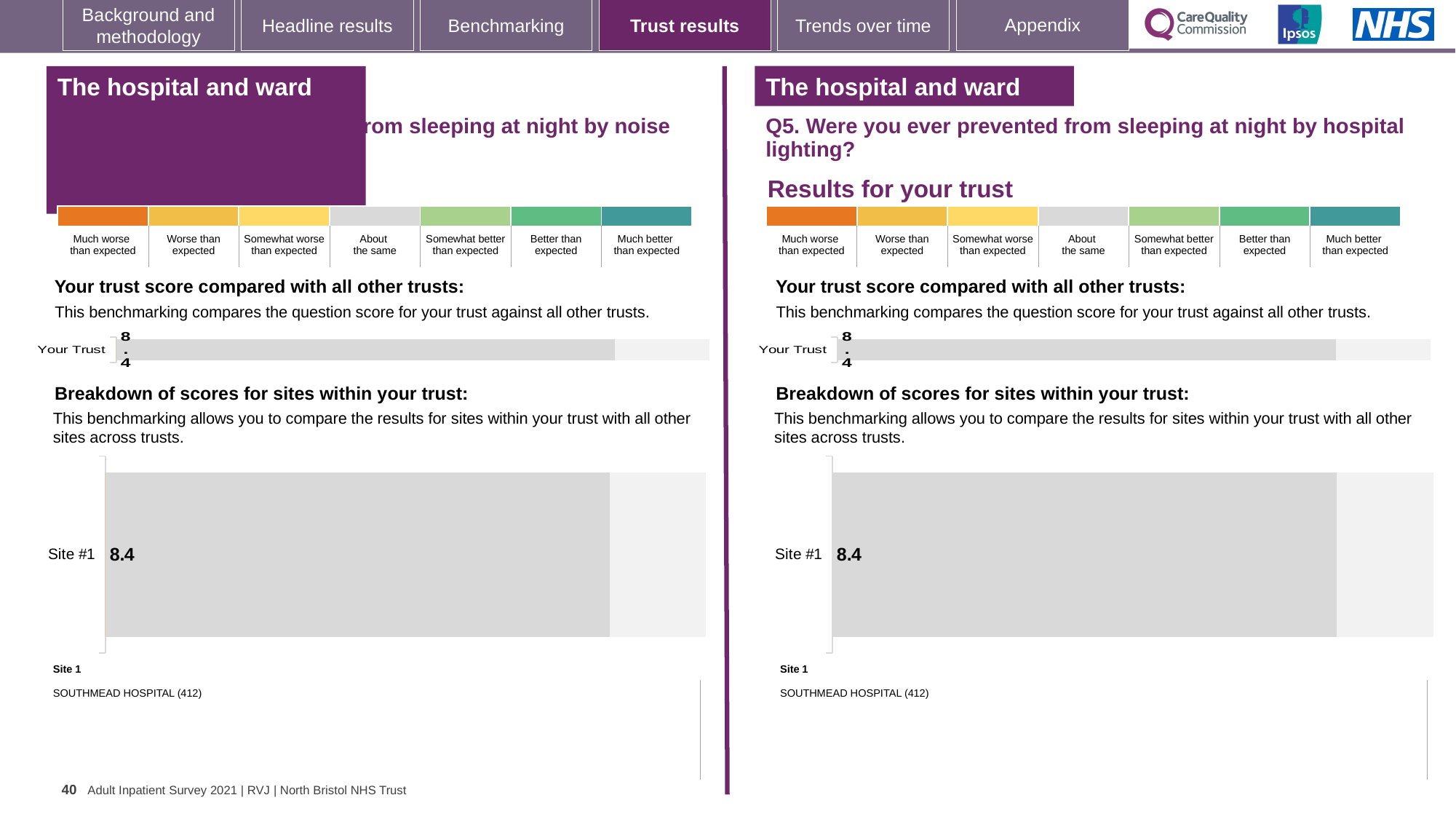
On the right half of the slide (Q5, hospital lighting), which hospital is listed as Site 1 below the site breakdown chart? SOUTHMEAD HOSPITAL (412) On the right half of the slide (Q5, hospital lighting), how many sites are shown in the 'Breakdown of scores for sites within your trust' chart? 1 Is the Site #1 score on the left half of the slide (sleeping at night by noise) larger than, smaller than, or equal to the Site #1 score on the right half (Q5, hospital lighting)? Equal On the right half of the slide (Q5, hospital lighting), how many categories does the colour key above the charts list, from 'Much worse than expected' to 'Much better than expected'? 7 On the left half of the slide (sleeping at night by noise), what is the score shown for Your Trust in the 'Your trust score compared with all other trusts' chart? 8.4 What kind of chart is used to show the Site #1 score on the right half of the slide (Q5, hospital lighting)? Bar chart On the left half of the slide (sleeping at night by noise), how many sites are shown in the 'Breakdown of scores for sites within your trust' chart? 1 On the right half of the slide (Q5, hospital lighting), what score is shown for Site #1 in the 'Breakdown of scores for sites within your trust' chart? 8.4 On the left half of the slide (sleeping at night by noise), what score is shown for Site #1 in the 'Breakdown of scores for sites within your trust' chart? 8.4 On the right half of the slide (Q5, hospital lighting), what is the score shown for Your Trust in the 'Your trust score compared with all other trusts' chart? 8.4 What kind of chart is used to show the Your Trust score on the left half of the slide (sleeping at night by noise)? Bar chart